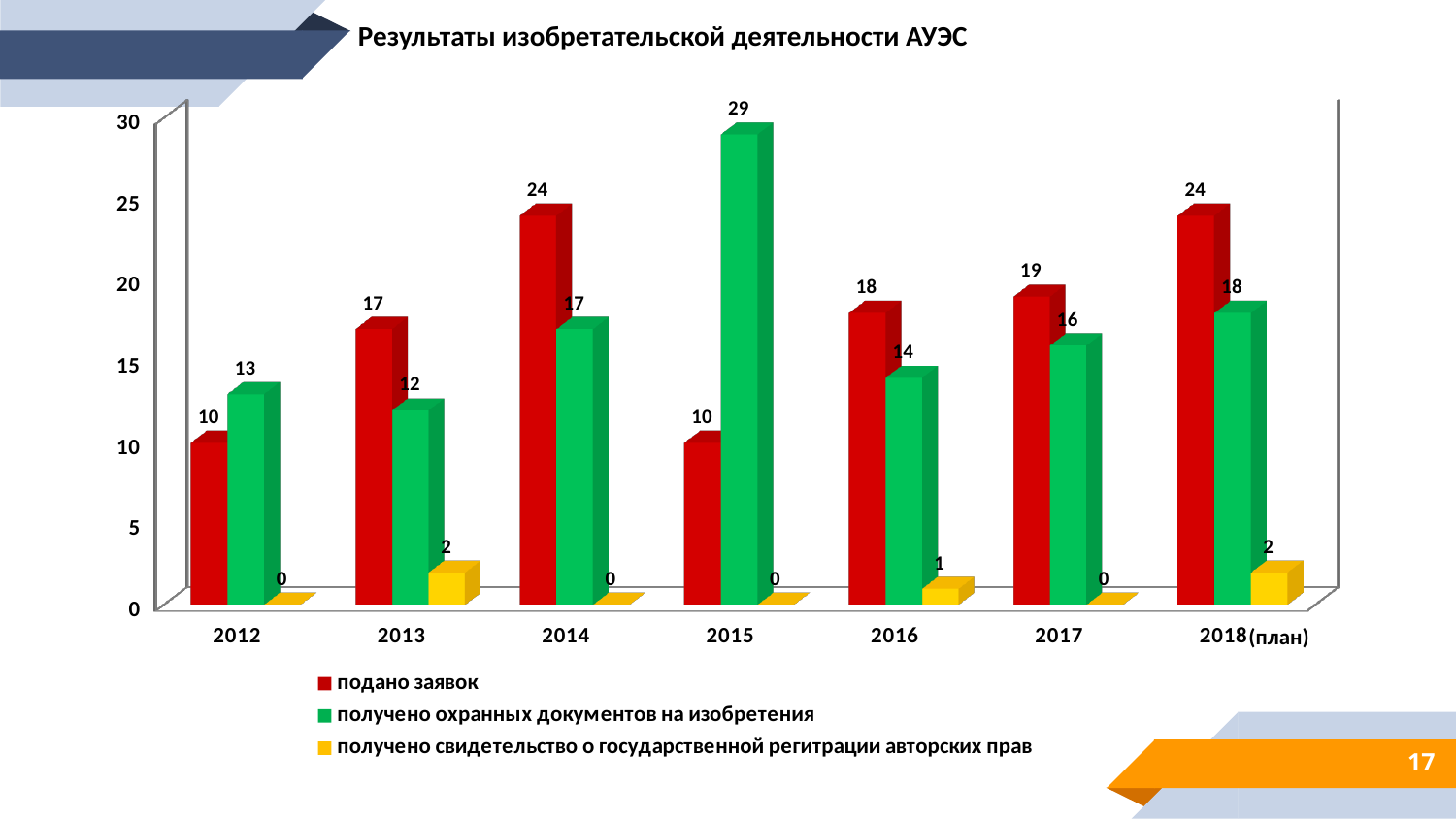
What is the title of the chart? Результаты изобретательской деятельности АУЭС How does the value for 'подано заявок' change from 2012 to 2014? It rises In which year is the value for 'получено охранных документов на изобретения' highest? 2015 What is the value for 'получено охранных документов на изобретения' in 2015? 29 Which is larger in 2017: 'подано заявок' or 'получено охранных документов на изобретения'? подано заявок How many year categories are shown on the x axis? 7 What is the value for 'получено свидетельство о государственной регитрации авторских прав' in 2016? 1 In which year is the value for 'получено охранных документов на изобретения' lowest? 2013 What is the difference between 'получено охранных документов на изобретения' and 'подано заявок' in 2015? 19 How many series does the legend list? 3 What is the value for 'подано заявок' in 2014? 24 What type of chart is shown on the slide? Bar chart